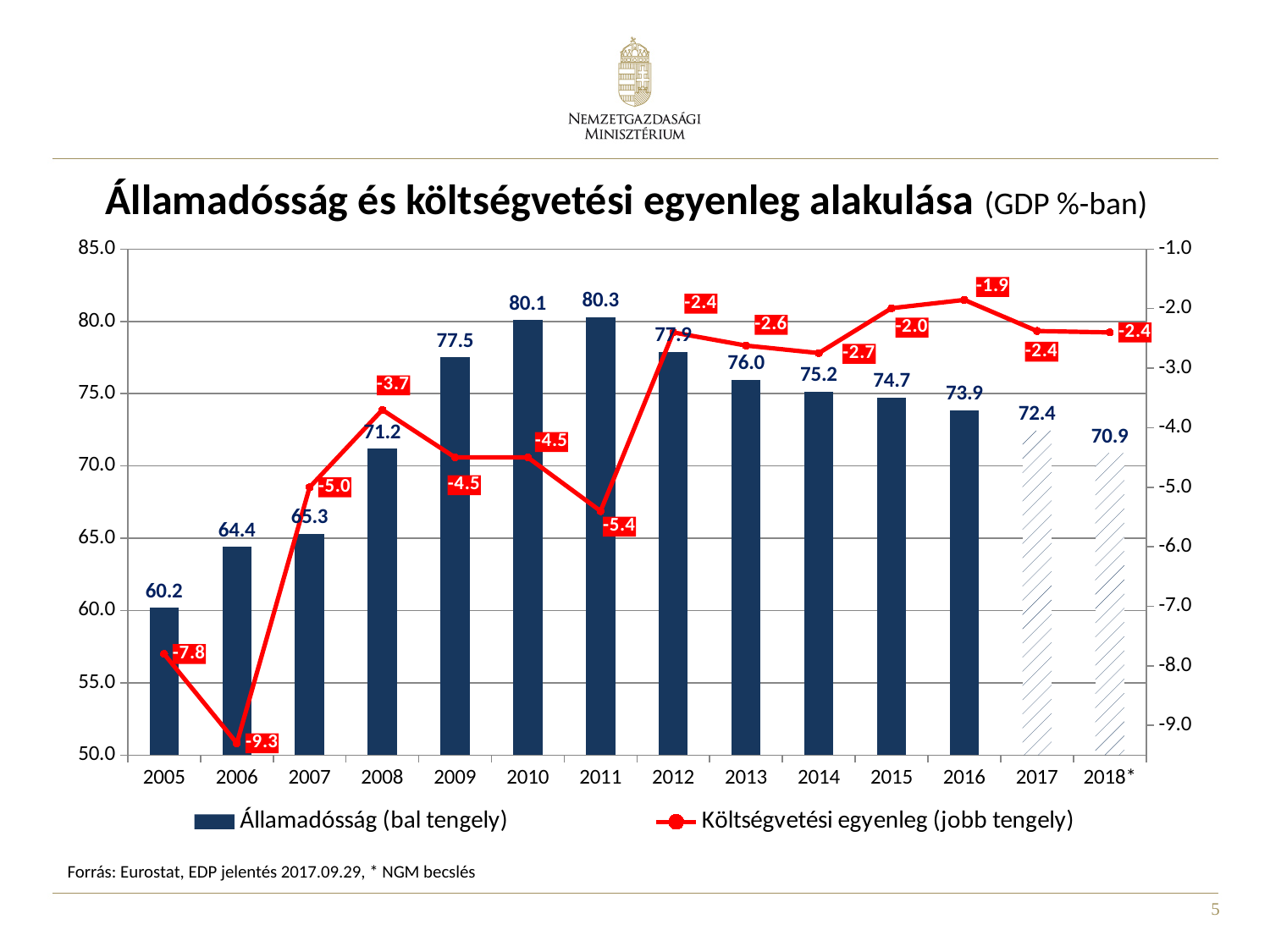
In which year is Költségvetési egyenleg (jobb tengely) lowest? 2006 How many series does the legend list? 2 What is the value of Államadósság (bal tengely) for 2018*? 70.9 What is the value of Államadósság (bal tengely) for 2009? 77.5 In which year is Államadósság (bal tengely) highest? 2011 In which year is Államadósság (bal tengely) lowest? 2005 What kind of chart is shown on the slide? Combined bar and line chart What is the difference between the Államadósság values for 2011 and 2005? 20.1 What is the value of Költségvetési egyenleg (jobb tengely) for 2006? -9.3 Does Államadósság (bal tengely) rise or fall from 2011 to 2018*? Fall Which year has a higher Államadósság value, 2013 or 2016? 2013 How many years are shown on the x axis? 14